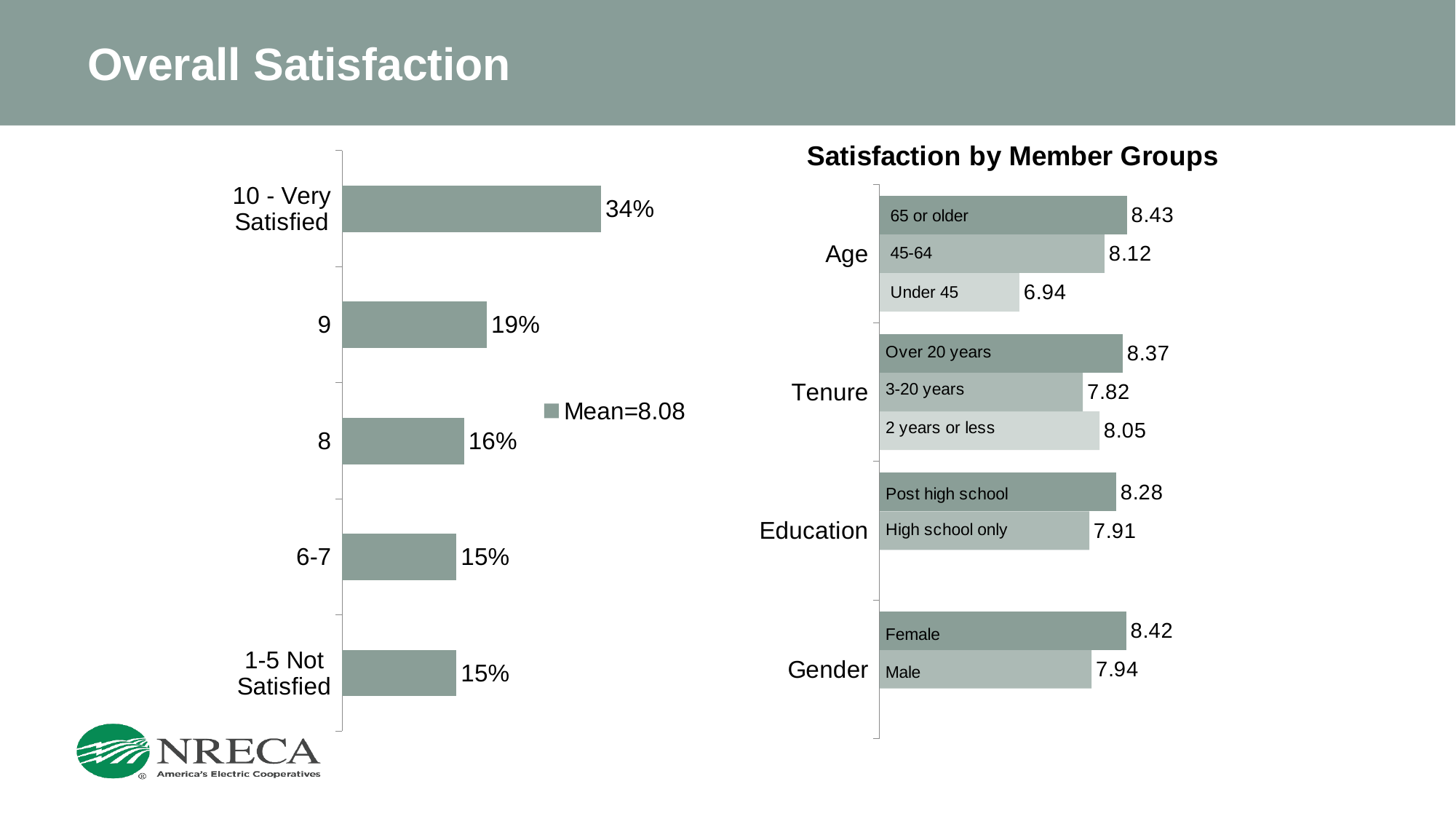
On the left chart, what mean value is shown in the legend? Mean=8.08 On the Satisfaction by Member Groups chart, which member group has the lowest satisfaction score? Under 45 On the left chart, which rating category has the highest percentage? 10 - Very Satisfied On the Satisfaction by Member Groups chart, what is the difference between the Post high school and High school only scores? 0.37 On the left chart, what percentage of respondents gave a rating of 9? 19% On the Satisfaction by Member Groups chart, which has a higher satisfaction score, Female or Male? Female On the Satisfaction by Member Groups chart, what is the satisfaction score for members with 2 years or less tenure? 8.05 What type of chart is the Satisfaction by Member Groups chart? Bar chart On the left chart, what is the difference in percentage points between the 10 - Very Satisfied category and the 8 category? 18 On the Satisfaction by Member Groups chart, what is the satisfaction score for members aged 65 or older? 8.43 On the left chart, what percentage of respondents gave a rating of 10 - Very Satisfied? 34% On the left chart, how many rating categories are shown? 5